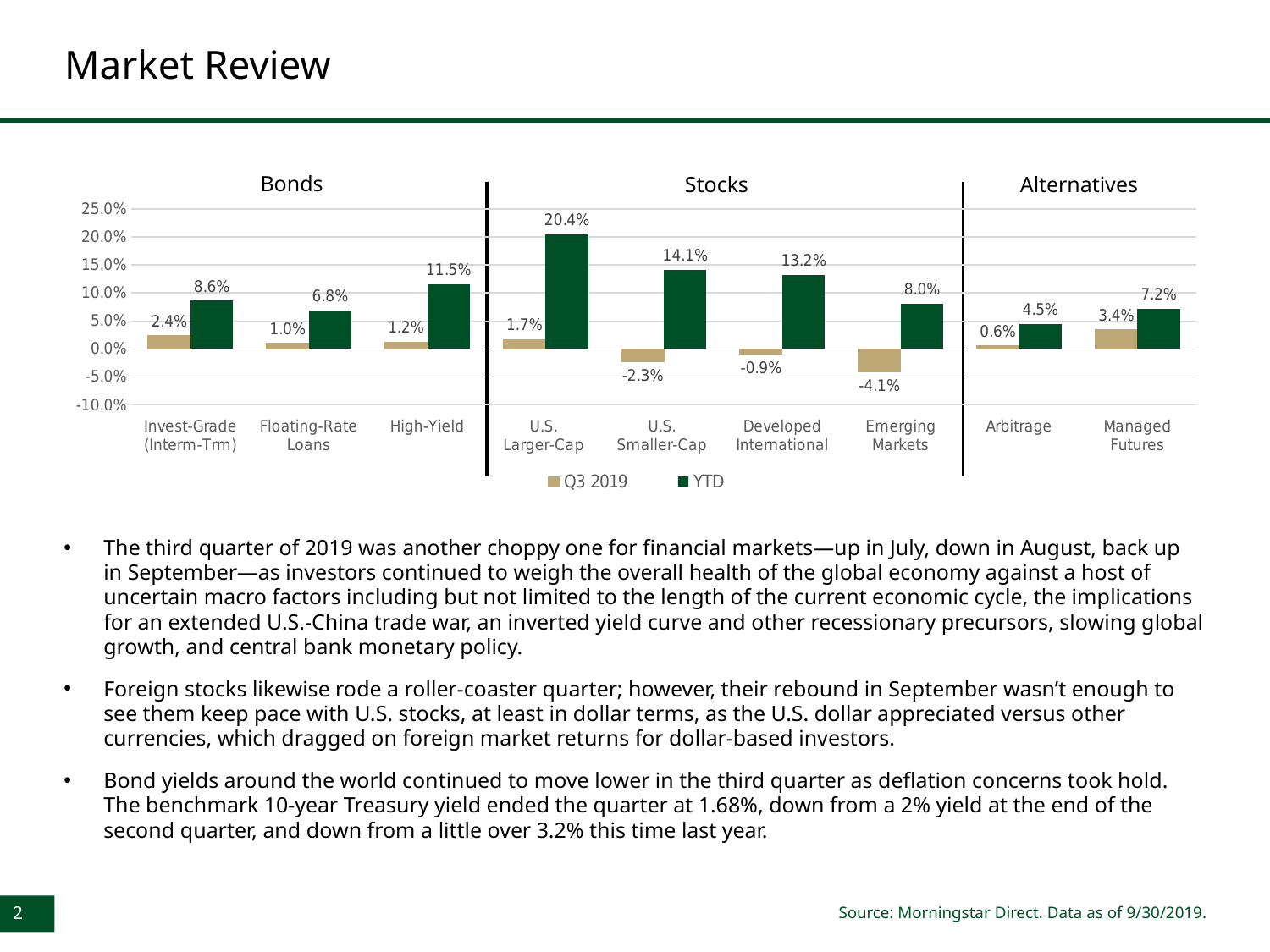
What is the Q3 2019 value for Managed Futures? 3.4% What kind of chart is shown on the slide? Bar chart What is the Q3 2019 value for Emerging Markets? -4.1% Which is larger, the YTD value for U.S. Smaller-Cap or for Developed International? U.S. Smaller-Cap Which category has the lowest Q3 2019 value? Emerging Markets Which category has the highest YTD value? U.S. Larger-Cap What is the YTD value for U.S. Larger-Cap? 20.4% What is the difference between the YTD and Q3 2019 values for Arbitrage? 3.9% How many categories are shown on the x axis of the chart? 9 What are the three group headings shown above the chart? Bonds, Stocks, Alternatives What is the difference between the YTD values for High-Yield and Floating-Rate Loans? 4.7% How many series does the legend list? 2